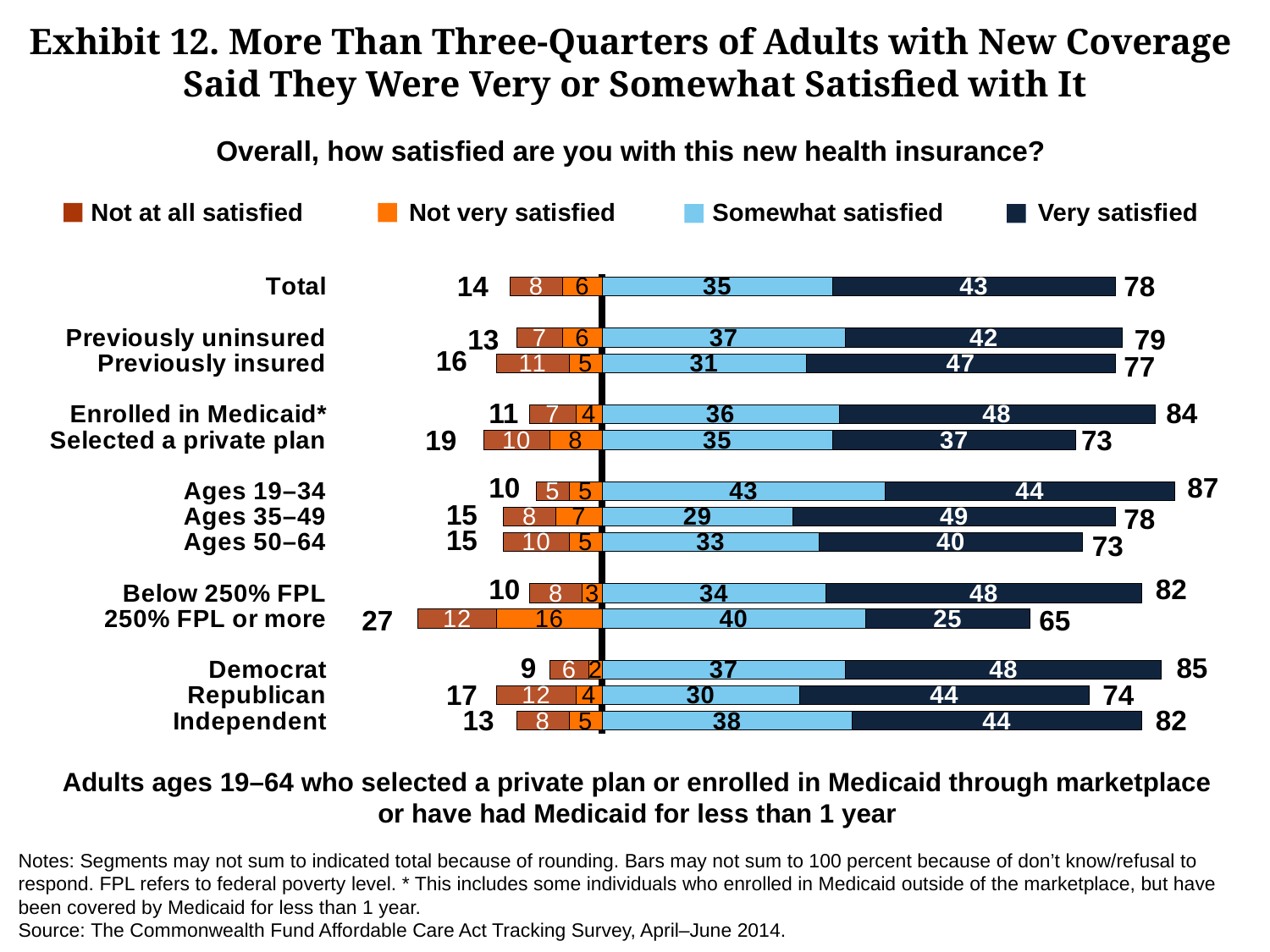
What kind of chart is shown on the slide? Stacked bar chart Which has a larger 'Very satisfied' value, Democrat or Republican? Democrat What percentage of the Total group said they were very satisfied? 43 Which group has the highest combined not at all or not very satisfied total shown at the left end of the bars? 250% FPL or more What is the 'Somewhat satisfied' value for Ages 19–34? 43 How many series does the legend list? 4 What is the difference between the 'Very satisfied' values for Enrolled in Medicaid* and Selected a private plan? 11 Which group has the highest combined very or somewhat satisfied total shown at the right end of the bars? Ages 19–34 Which legend entry is shown in the darkest colour? Very satisfied What is the 'Not very satisfied' value for the '250% FPL or more' group? 16 How many groups (categories) are plotted in the chart? 13 Which group has the lowest combined very or somewhat satisfied total shown at the right end of the bars? 250% FPL or more